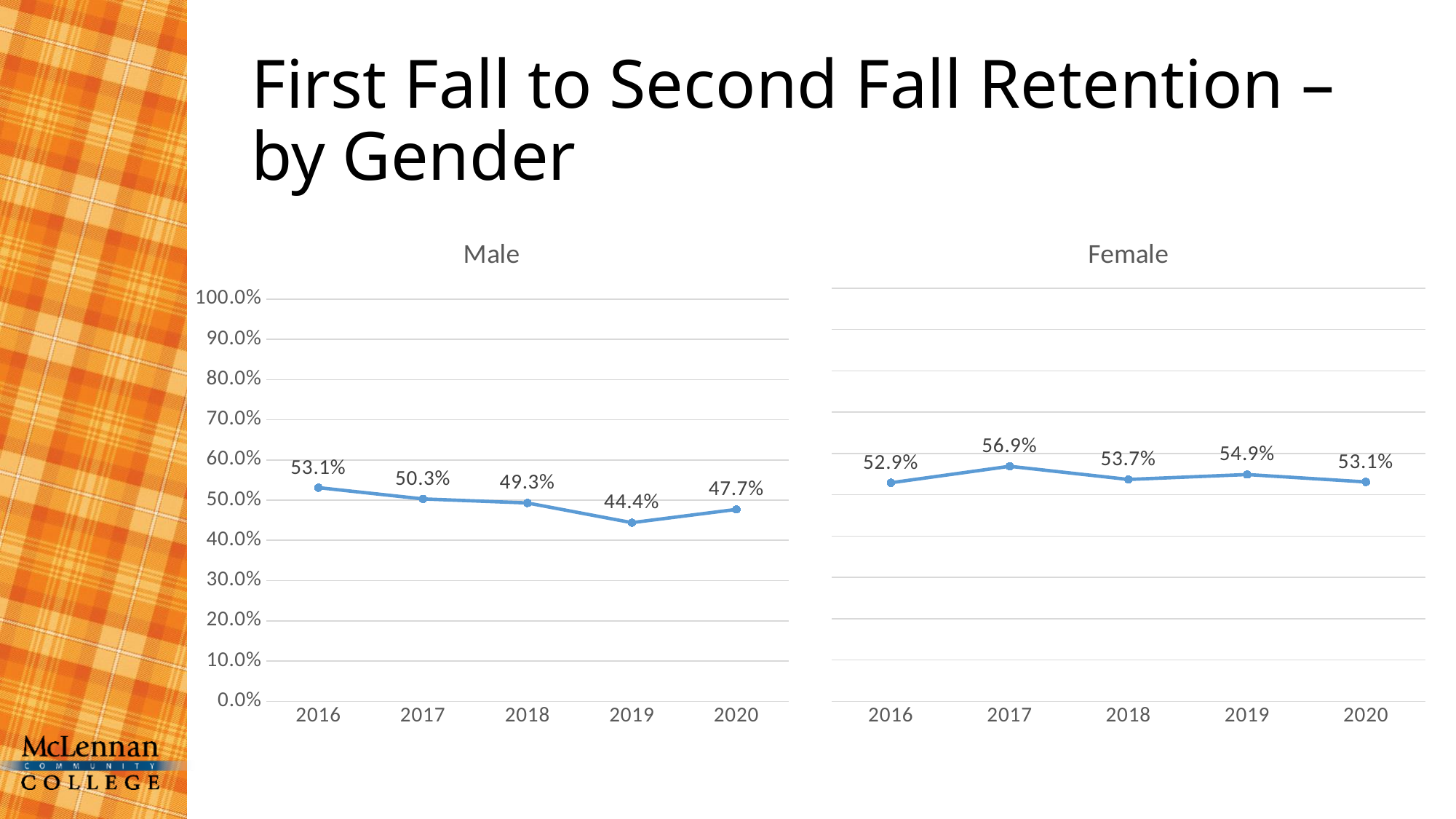
How many years are plotted in the Male chart? 5 Which is larger: the Male 2020 retention rate or the Female 2020 retention rate? Female 2020 In the Male chart, what is the retention rate for 2016? 53.1% In the Male chart, do the values rise or fall from 2016 to 2019? fall In the Male chart, which year has the lowest retention rate? 2019 What is the title of the slide? First Fall to Second Fall Retention – by Gender In the Female chart, what is the difference between the 2017 and 2020 retention rates? 3.8% In the Male chart, is the value for 2019 greater or less than 50.0%? less In the Male chart, what is the difference between the 2016 and 2019 retention rates? 8.7% In the Female chart, which year has the highest retention rate? 2017 What kind of chart is the Female chart? line chart In the Female chart, what is the retention rate for 2017? 56.9%